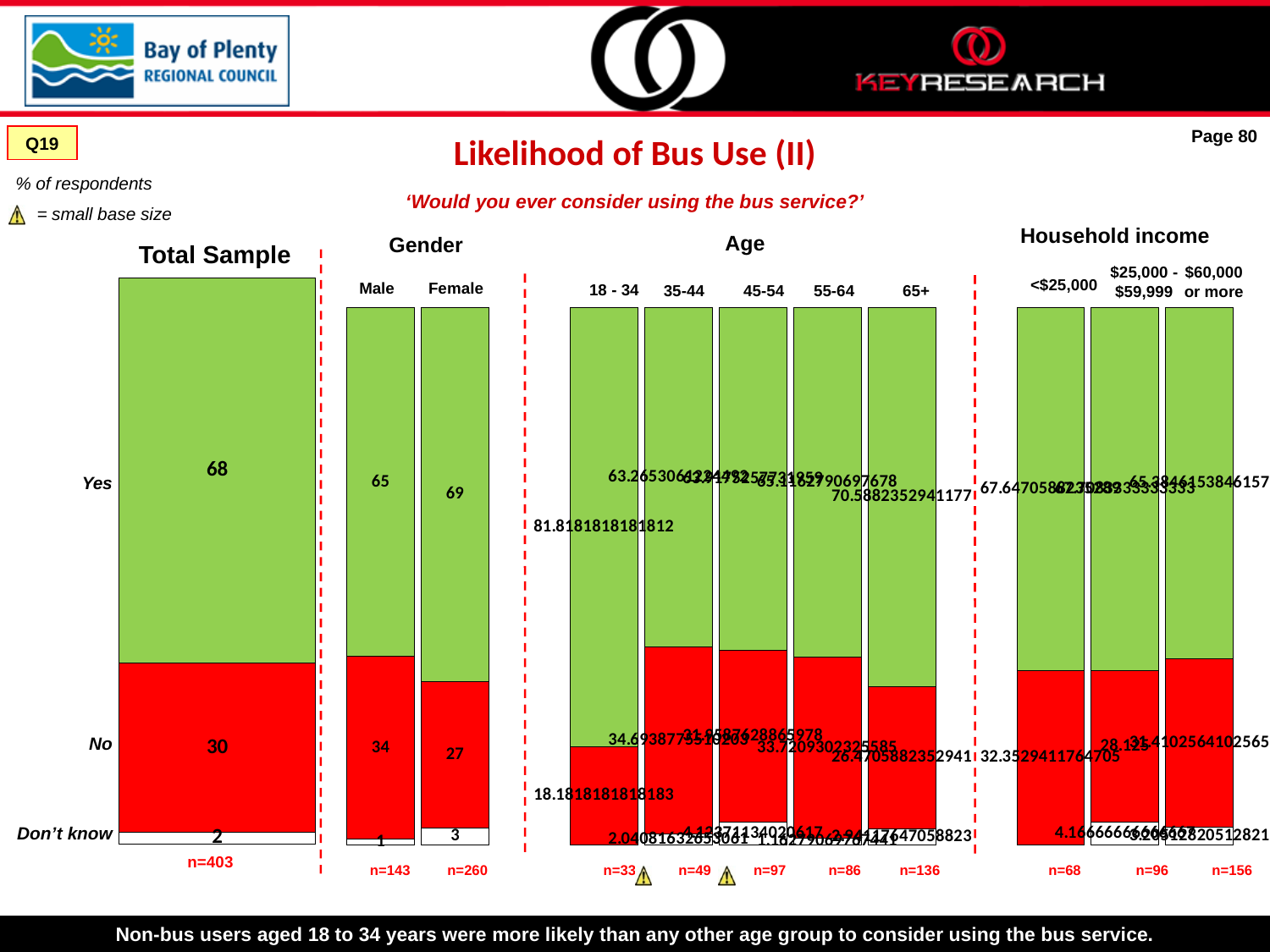
In the Total Sample chart, what is the value for 'Don't know'? 2 In the Age chart, what is the 'Yes' value for the 18 - 34 group? 81.8181818181812 In the Total Sample chart, what is the total of the stacked bar (Yes + No + Don't know)? 100 In the Gender chart, what is the 'Yes' value for Male? 65 What kind of chart is used on this slide? Stacked bar chart In the Gender chart, what is the difference between the 'No' values for Male and Female? 7 In the Total Sample chart, what is the value for 'No'? 30 In the Total Sample chart, what percentage of respondents answered 'Yes'? 68 How many age groups are shown in the Age chart? 5 In the Gender chart, what is the 'No' value for Female? 27 In the Gender chart, which group has the higher 'Yes' value, Male or Female? Female In the Age chart, which age group has the highest 'Yes' value? 18 - 34